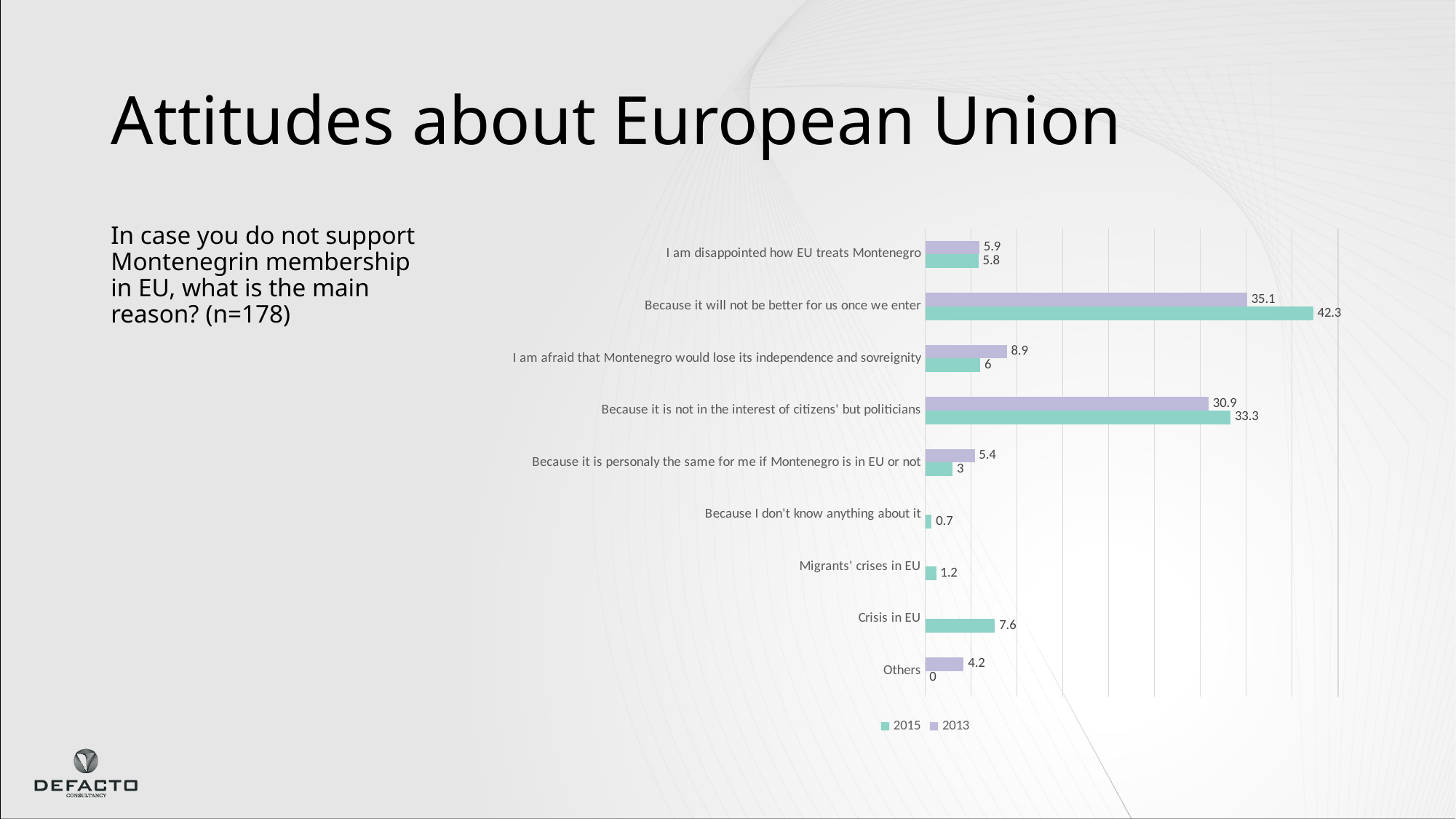
Which category has the highest 2015 value? Because it will not be better for us once we enter Which is larger for "Because it is personaly the same for me if Montenegro is in EU or not": the 2013 value or the 2015 value? 2013 What is the 2013 value for "I am afraid that Montenegro would lose its independence and sovreignity"? 8.9 What kind of chart is shown on the slide? Bar chart Which colour represents the 2015 series in the chart? Teal (green) How many series does the legend list? 2 What is the 2015 value for "Crisis in EU"? 7.6 What is the difference between the 2015 and 2013 values for "Because it will not be better for us once we enter"? 7.2 Which category has the lowest 2013 value among those with a 2013 bar? Others What is the 2015 value for "Because it will not be better for us once we enter"? 42.3 What is the 2013 value for "Because it is not in the interest of citizens' but politicians"? 30.9 How many categories are shown on the chart? 9